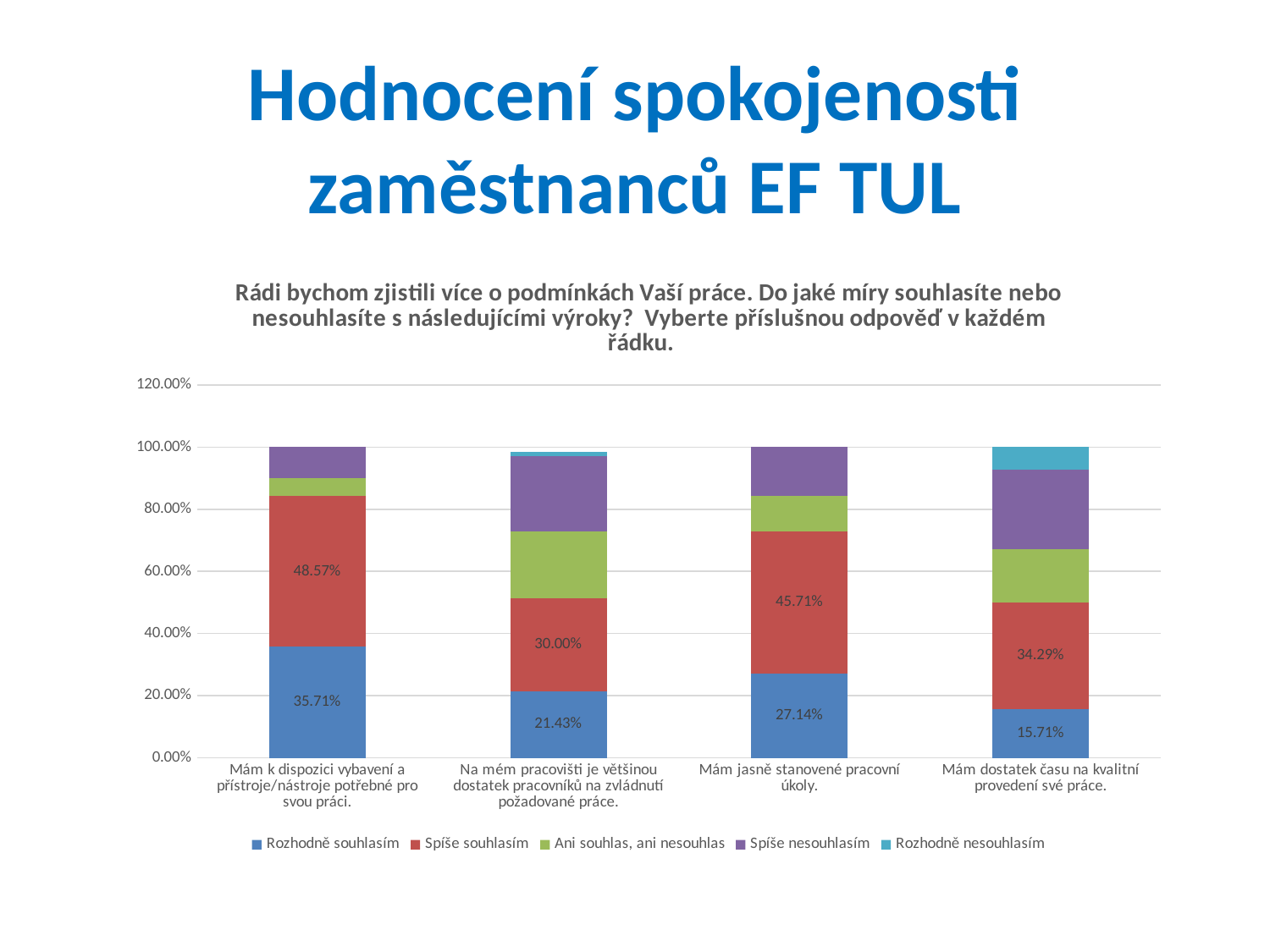
Which category has the lowest value for "Spíše souhlasím"? Na mém pracovišti je většinou dostatek pracovníků na zvládnutí požadované práce. Is the "Spíše nesouhlasím" value for "Mám dostatek času na kvalitní provedení své práce." greater or less than 20.00%? greater What is the difference between the "Spíše souhlasím" values for "Mám k dispozici vybavení a přístroje/nástroje potřebné pro svou práci." and "Mám dostatek času na kvalitní provedení své práce."? 14.28% What is the value of "Rozhodně souhlasím" for the category "Mám dostatek času na kvalitní provedení své práce."? 15.71% What kind of chart is shown on the slide? Stacked bar chart What is the value of "Spíše souhlasím" for the category "Mám jasně stanovené pracovní úkoly."? 45.71% What is the value of "Rozhodně souhlasím" for the category "Mám k dispozici vybavení a přístroje/nástroje potřebné pro svou práci."? 35.71% How many series does the legend list? 5 How many categories are shown on the x axis of the chart? 4 Which is larger: the "Rozhodně souhlasím" value for "Mám jasně stanovené pracovní úkoly." or for "Na mém pracovišti je většinou dostatek pracovníků na zvládnutí požadované práce."? Mám jasně stanovené pracovní úkoly. What is the value of "Spíše souhlasím" for the category "Na mém pracovišti je většinou dostatek pracovníků na zvládnutí požadované práce."? 30.00% Which category has the highest value for "Rozhodně souhlasím"? Mám k dispozici vybavení a přístroje/nástroje potřebné pro svou práci.